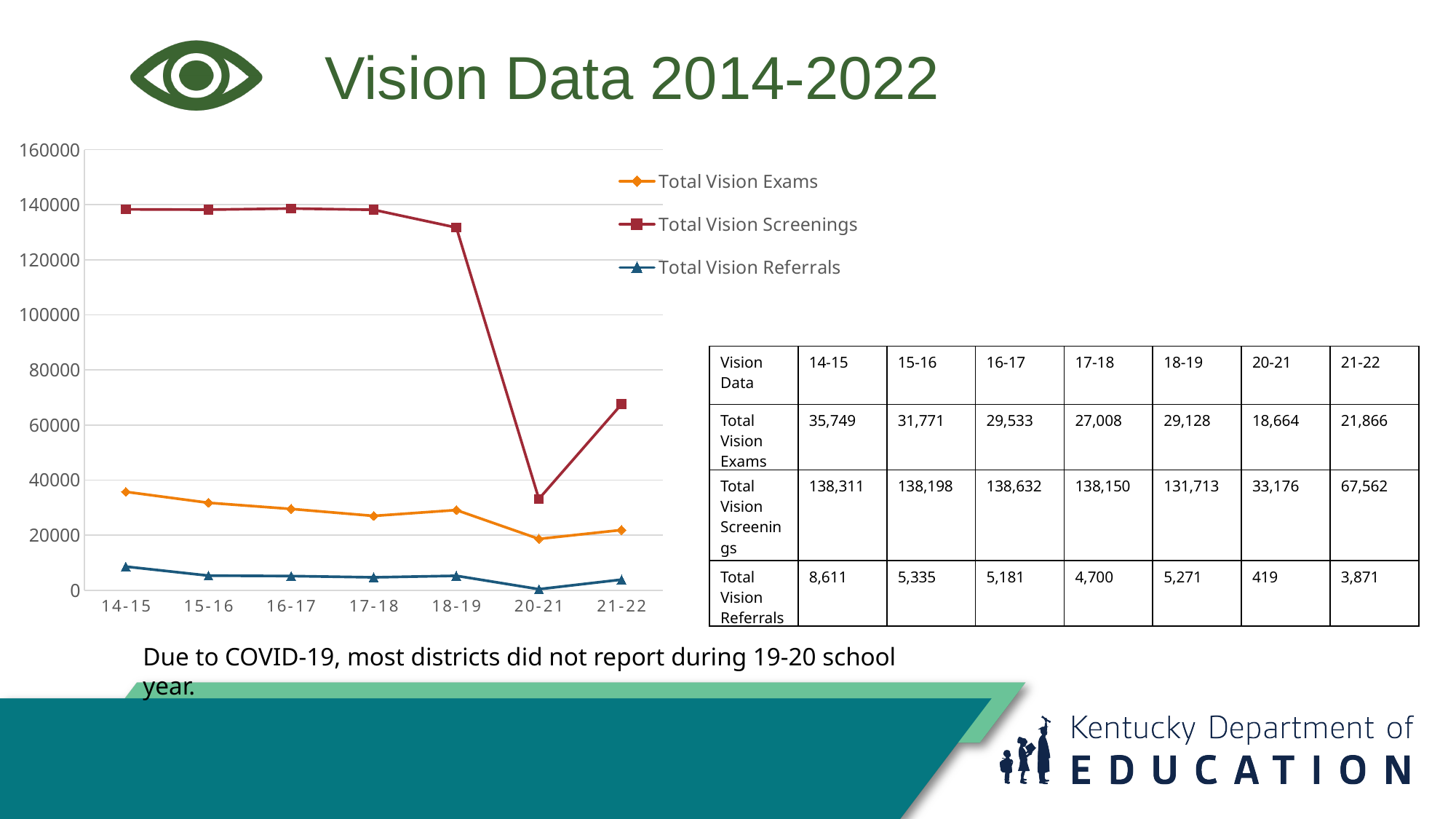
Is the value for Total Vision Screenings in 16-17 greater or less than 120000? greater What is the value of Total Vision Screenings for 20-21? 33,176 What is the value of Total Vision Referrals for 21-22? 3,871 Which is larger, Total Vision Exams in 18-19 or Total Vision Exams in 17-18? 18-19 In which school year is Total Vision Screenings lowest? 20-21 How many series does the chart legend list? 3 Which series is drawn with a red line and square markers? Total Vision Screenings What kind of chart is shown on the slide? line chart What is the value of Total Vision Exams for 14-15? 35,749 In which school year is Total Vision Exams highest? 14-15 What is the difference between Total Vision Screenings in 21-22 and 20-21? 34,386 How many school years are plotted along the x axis of the chart? 7